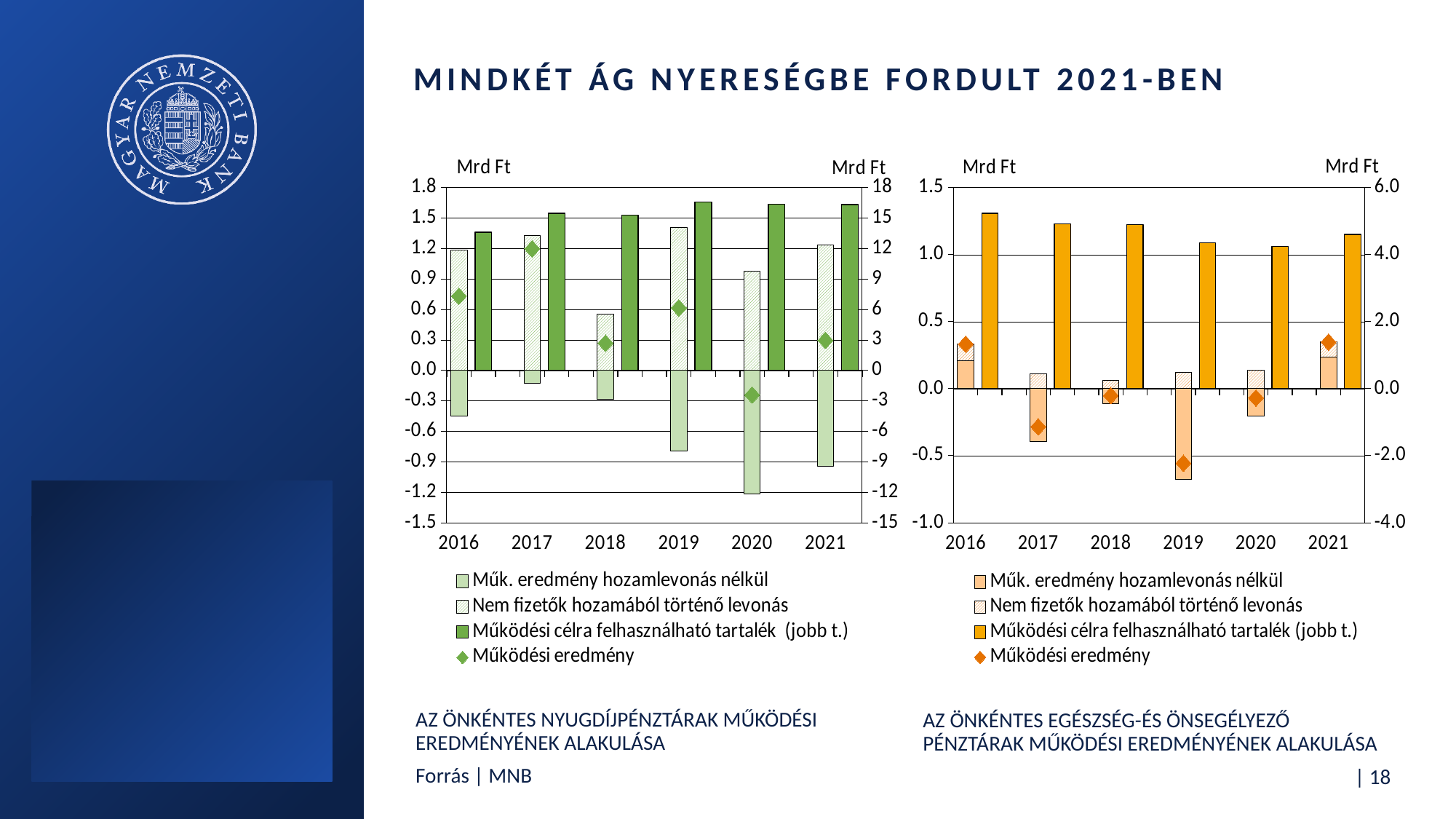
On the left chart (Az önkéntes nyugdíjpénztárak működési eredményének alakulása), in which year is the Működési célra felhasználható tartalék bar lowest? 2016 On the left chart (Az önkéntes nyugdíjpénztárak működési eredményének alakulása), how many years are shown on the x axis? 6 On the right chart (Az önkéntes egészség- és önsegélyező pénztárak működési eredményének alakulása), in which year is the Működési célra felhasználható tartalék bar highest? 2016 On the left chart (Az önkéntes nyugdíjpénztárak működési eredményének alakulása), in which year is the Működési eredmény marker highest? 2017 On the left chart (Az önkéntes nyugdíjpénztárak működési eredményének alakulása), is the Műk. eredmény hozamlevonás nélkül value for 2020 greater or less than -0.9? less What unit is shown on the axes of both charts? Mrd Ft On the right chart (Az önkéntes egészség- és önsegélyező pénztárak működési eredményének alakulása), in which year is the Működési eredmény marker lowest? 2019 On the right chart (Az önkéntes egészség- és önsegélyező pénztárak működési eredményének alakulása), which is larger: the Működési célra felhasználható tartalék bar for 2016 or for 2020? 2016 On the right chart (Az önkéntes egészség- és önsegélyező pénztárak működési eredményének alakulása), is the Működési célra felhasználható tartalék bar for 2016 greater or less than 4.0 on the right axis? greater On the left chart (Az önkéntes nyugdíjpénztárak működési eredményének alakulása), how many series does the legend list? 4 On the left chart (Az önkéntes nyugdíjpénztárak működési eredményének alakulása), in which year is the Működési eredmény marker lowest? 2020 On the left chart (Az önkéntes nyugdíjpénztárak működési eredményének alakulása), is the Működési eredmény value for 2017 greater or less than 0.9? greater